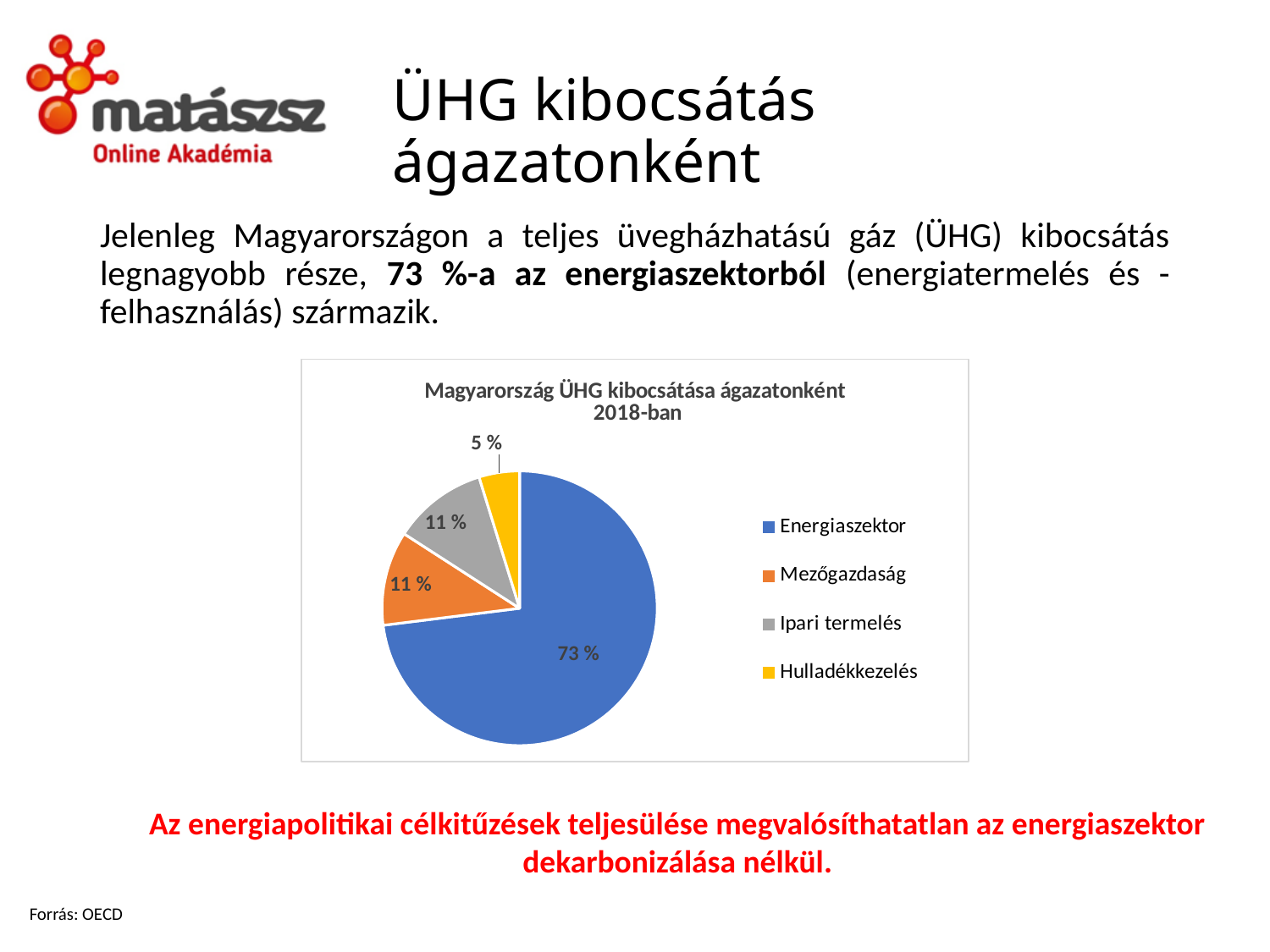
What is the value shown for Mezőgazdaság? 11 % What is the difference between the Energiaszektor share and the Hulladékkezelés share? 68 % What share of the pie does Energiaszektor have? 73 % What is the difference between the Energiaszektor share and the Mezőgazdaság share? 62 % What is the value shown for Ipari termelés? 11 % What is the title of the chart? Magyarország ÜHG kibocsátása ágazatonként 2018-ban Which sector has the smallest slice of the pie? Hulladékkezelés What kind of chart is shown on the slide? pie chart What is the value shown for Hulladékkezelés? 5 % Which sector has the largest slice of the pie? Energiaszektor Which is larger, the share for Mezőgazdaság or the share for Hulladékkezelés? Mezőgazdaság How many sectors are shown in the pie chart? 4